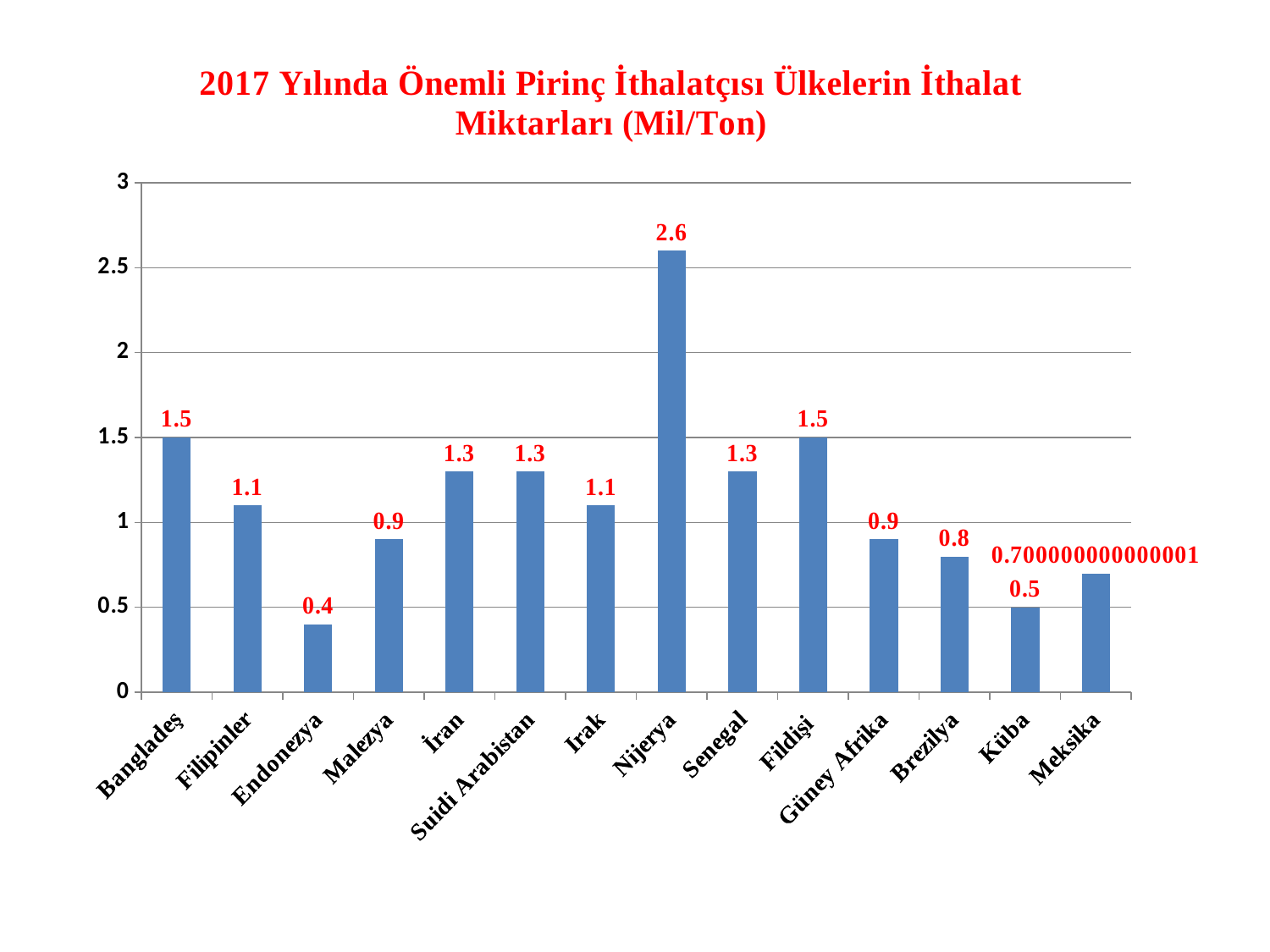
What is the difference between the import amounts of Nijerya and Fildişi? 1.1 Which country has the lowest import amount? Endonezya Which has a larger import amount, Brezilya or Küba? Brezilya What is the import amount for Suidi Arabistan? 1.3 Which country has the highest import amount? Nijerya What is the title of the chart? 2017 Yılında Önemli Pirinç İthalatçısı Ülkelerin İthalat Miktarları (Mil/Ton) Is the value for Meksika greater or less than 1? less What is the import amount for Nijerya? 2.6 What type of chart is shown on the slide? bar chart What is the import amount for Güney Afrika? 0.9 How many countries are shown on the chart? 14 What is the import amount for Endonezya? 0.4